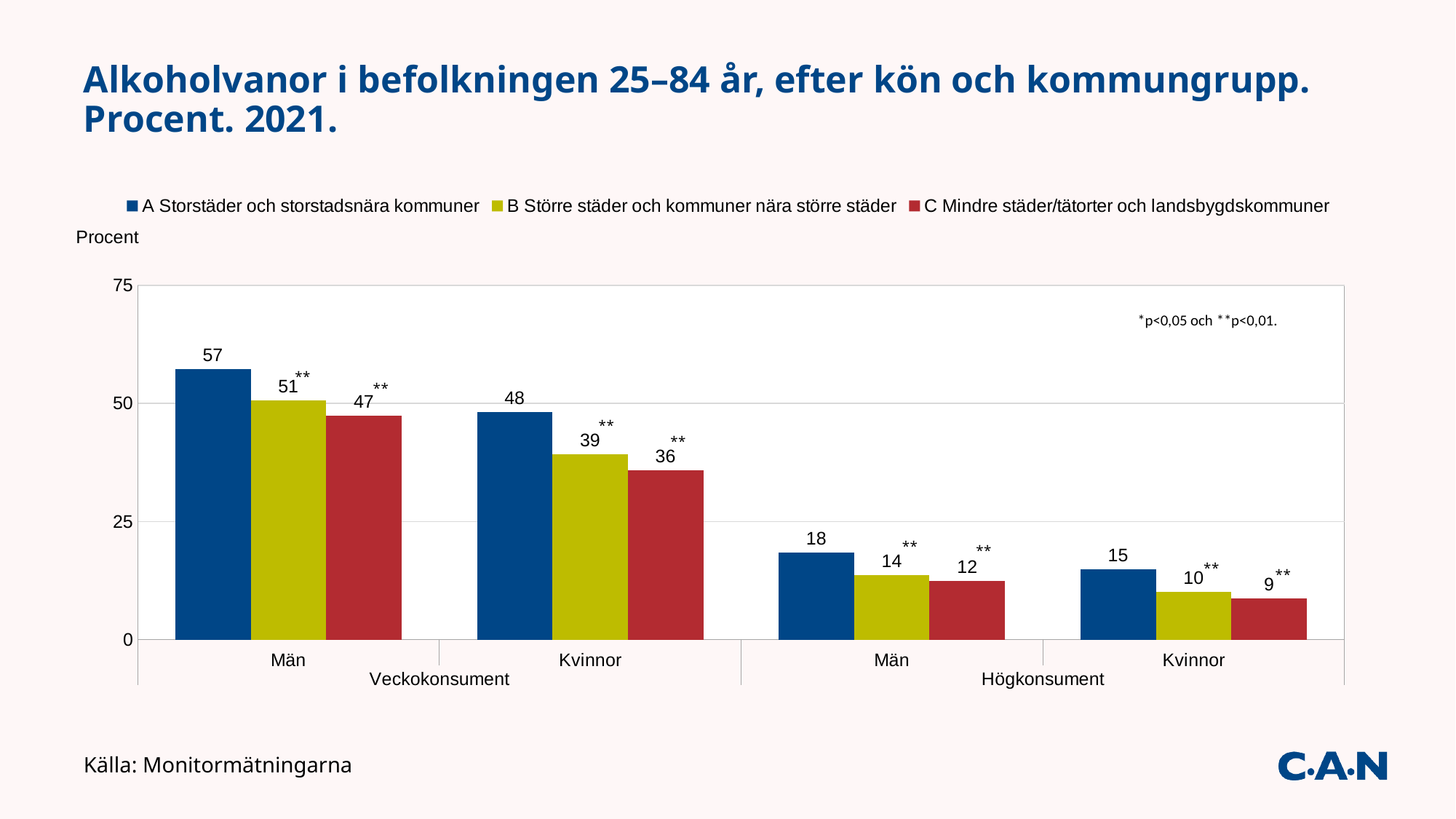
Which bar has the highest value in the chart? Series A, Män, Veckokonsument (57) What is the value for series B (Större städer och kommuner nära större städer) for Män under Högkonsument? 14 Which is larger: series B for Män under Veckokonsument or series A for Kvinnor under Veckokonsument? Series B for Män under Veckokonsument (51) What is the difference between series A and series B for Kvinnor under Veckokonsument? 9 What kind of chart is shown on the slide? Bar chart Which bar has the lowest value in the chart? Series C, Kvinnor, Högkonsument (9) Is the value for series A for Män under Högkonsument greater or less than 25? less How many series does the legend list? 3 What is the value for series C for Kvinnor under Högkonsument? 9 What is the value for series C (Mindre städer/tätorter och landsbygdskommuner) for Kvinnor under Veckokonsument? 36 What is the value for series A (Storstäder och storstadsnära kommuner) for Män under Veckokonsument? 57 What is the difference between series A and series C for Män under Veckokonsument? 10